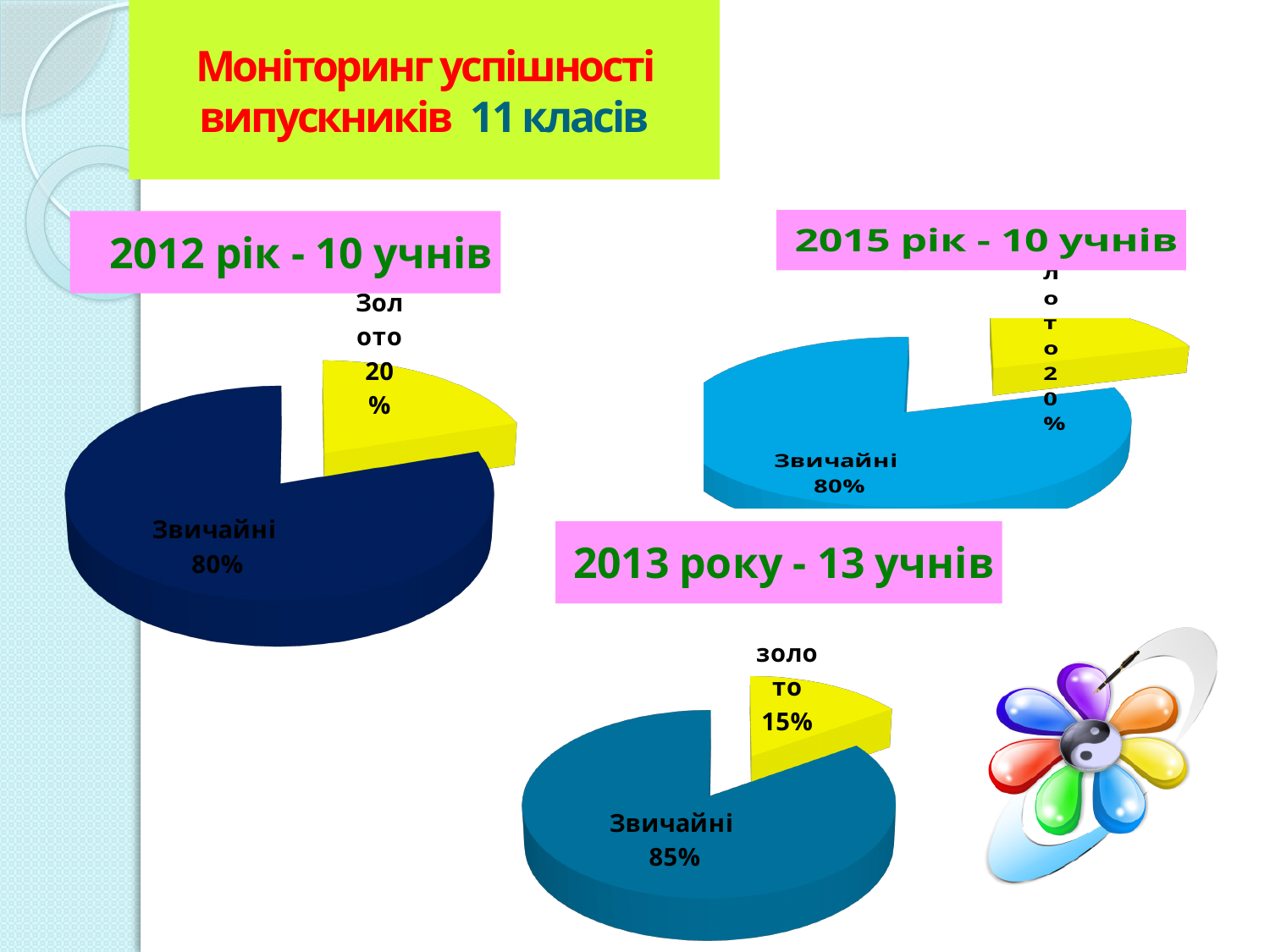
In the chart for 2012 рік - 10 учнів, which slice is the smallest? Золото In the chart for 2013 року - 13 учнів, what share is labelled Звичайні? 85% In the chart for 2013 року - 13 учнів, which slice is the largest? Звичайні What kind of chart is used for 2013 року - 13 учнів? Pie chart How many slices does the chart for 2015 рік - 10 учнів have? 2 How many pie charts are shown on the slide? 3 Which is larger in the chart for 2012 рік - 10 учнів: Золото or Звичайні? Звичайні In the chart for 2013 року - 13 учнів, what is the difference between the Звичайні and золото shares? 70% In the chart for 2015 рік - 10 учнів, what share is labelled Звичайні? 80% In the chart for 2012 рік - 10 учнів, what share is labelled Золото? 20% In the chart for 2013 року - 13 учнів, what share is labelled золото? 15% In the chart for 2012 рік - 10 учнів, what share is labelled Звичайні? 80%